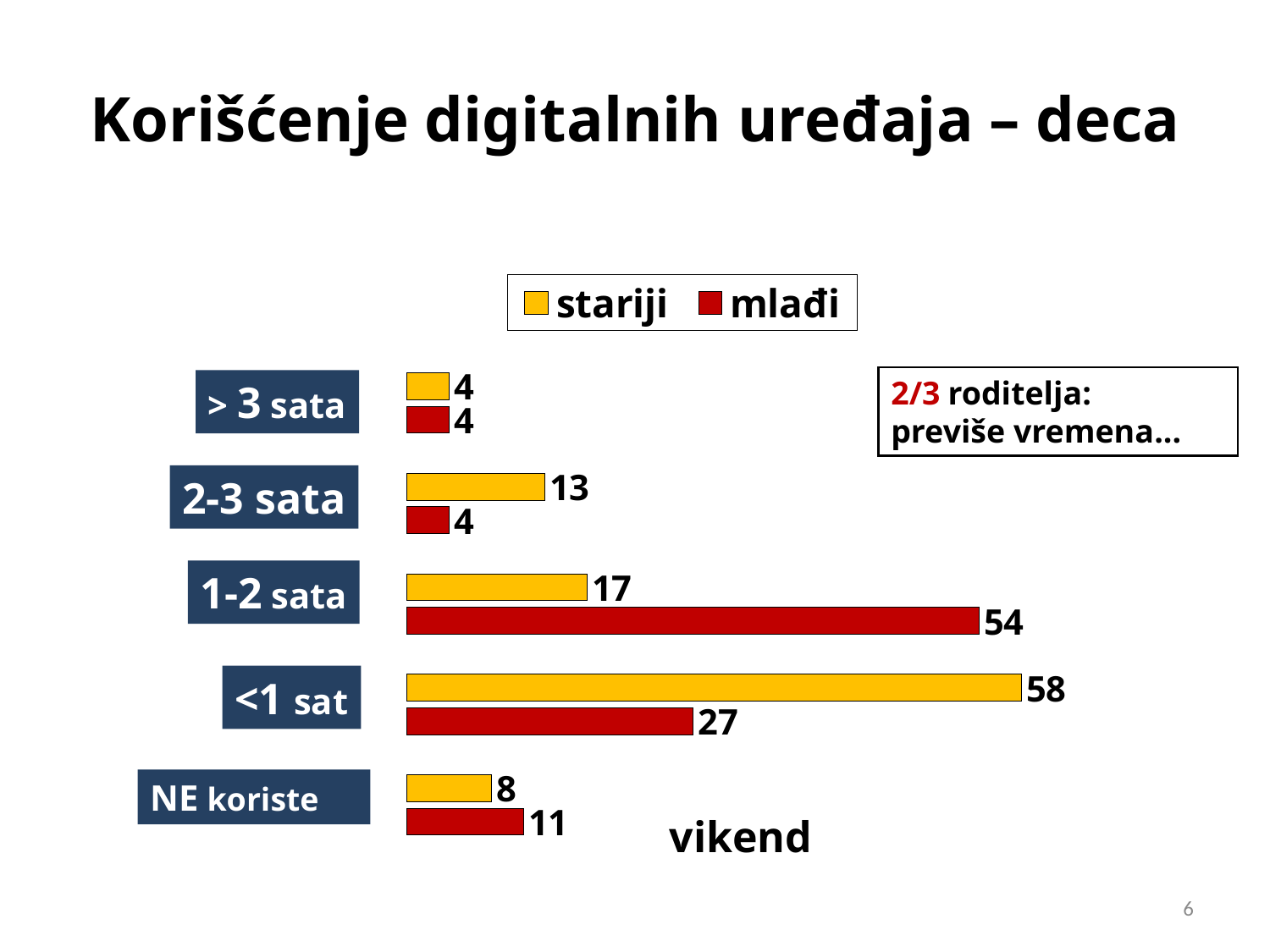
What is the difference between the 'mlađi' and 'stariji' values in the '1-2 sata' category? 37 What is the value for 'mlađi' in the '1-2 sata' category? 54 What is the difference between the 'stariji' and 'mlađi' values in the '<1 sat' category? 31 How many series does the legend list? 2 What is the value for 'mlađi' in the 'NE koriste' category? 11 Which category has the highest value for the 'mlađi' series? 1-2 sata Which category has the highest value for the 'stariji' series? <1 sat How many categories are shown in the chart? 5 In the 'NE koriste' category, which series has the larger value, 'stariji' or 'mlađi'? mlađi What is the value for 'stariji' in the '2-3 sata' category? 13 What is the value for 'stariji' in the '<1 sat' category? 58 What kind of chart is shown on the slide? bar chart